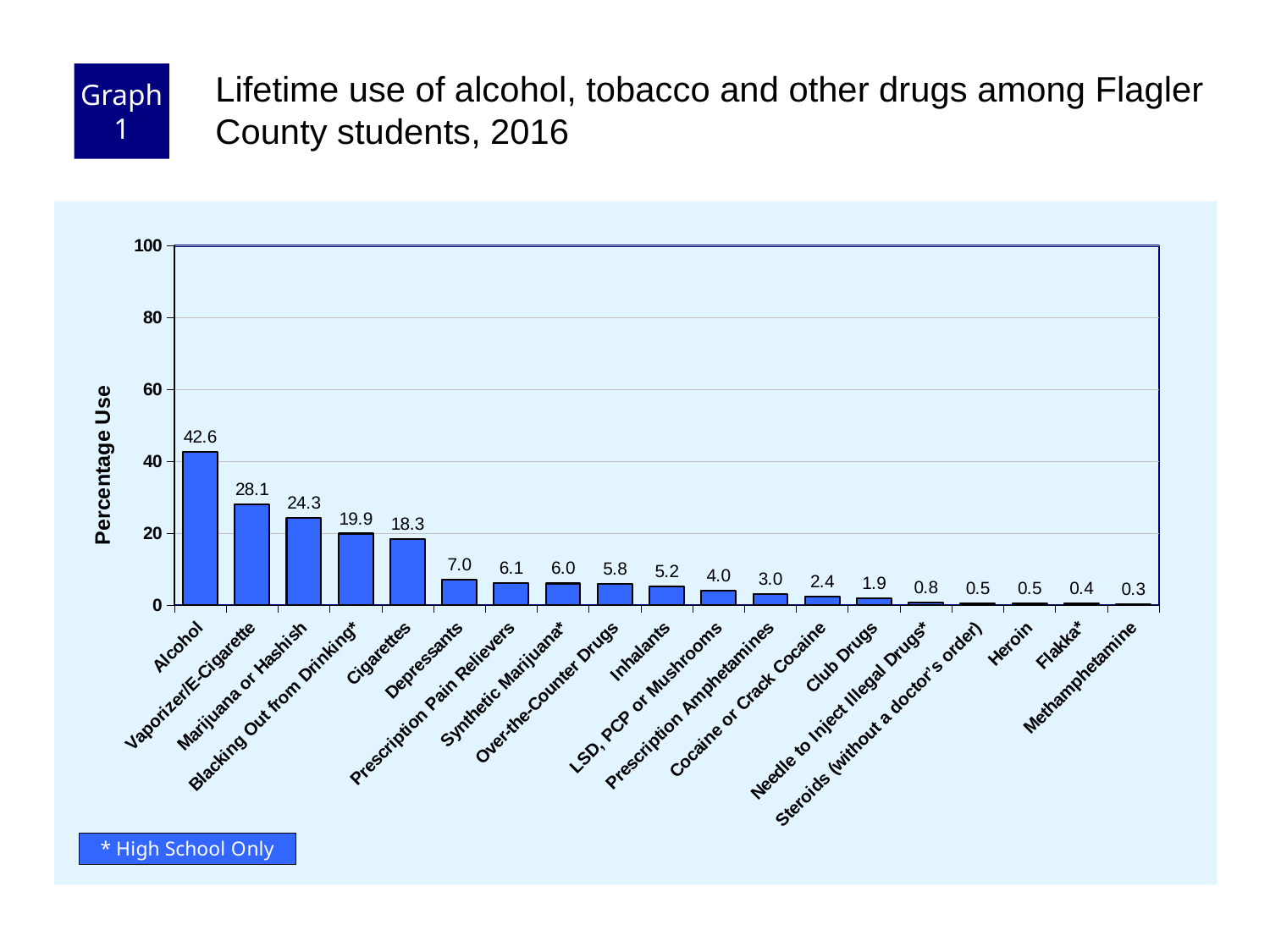
What is the value shown for Inhalants? 5.2 What is the value shown for Cigarettes? 18.3 What kind of chart is shown on the slide? Bar chart What is the difference between the values for Marijuana or Hashish and Cigarettes? 6.0 Which is larger, the value for Depressants or the value for Club Drugs? Depressants What is the difference between the values for Alcohol and Vaporizer/E-Cigarette? 14.5 Which category has the lowest lifetime use percentage? Methamphetamine What is the lifetime use percentage for Alcohol? 42.6 What is the value shown for Vaporizer/E-Cigarette? 28.1 Is the value for Blacking Out from Drinking* greater or less than 20? less How many categories are shown on the x axis? 19 Which category has the highest lifetime use percentage? Alcohol